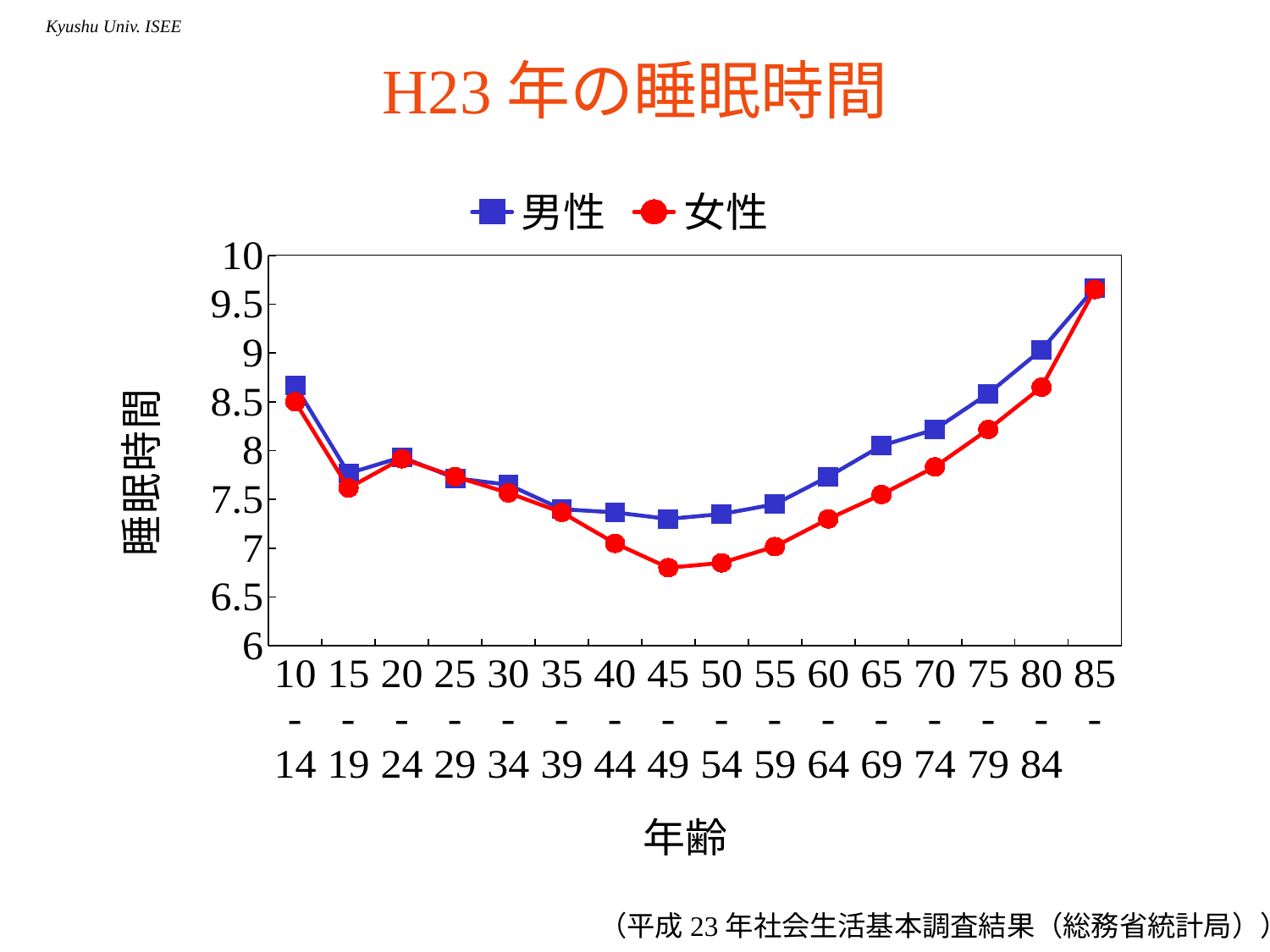
Is the value for 女性 at 80-84 greater or less than 9? less How many age categories are plotted along the x axis? 16 How many series does the legend list? 2 What kind of chart is shown on the slide? line chart Which age group has the highest value for 女性? 85- Is the value for 女性 at 45-49 greater or less than 7? less Is the value for 男性 at 10-14 greater or less than 8.5? greater What is the title of the chart? H23年の睡眠時間 From 50-54 to 85-, does the 女性 line rise or fall? rise At 60-64, which series has the larger value, 男性 or 女性? 男性 Which age group has the highest value for 男性? 85-